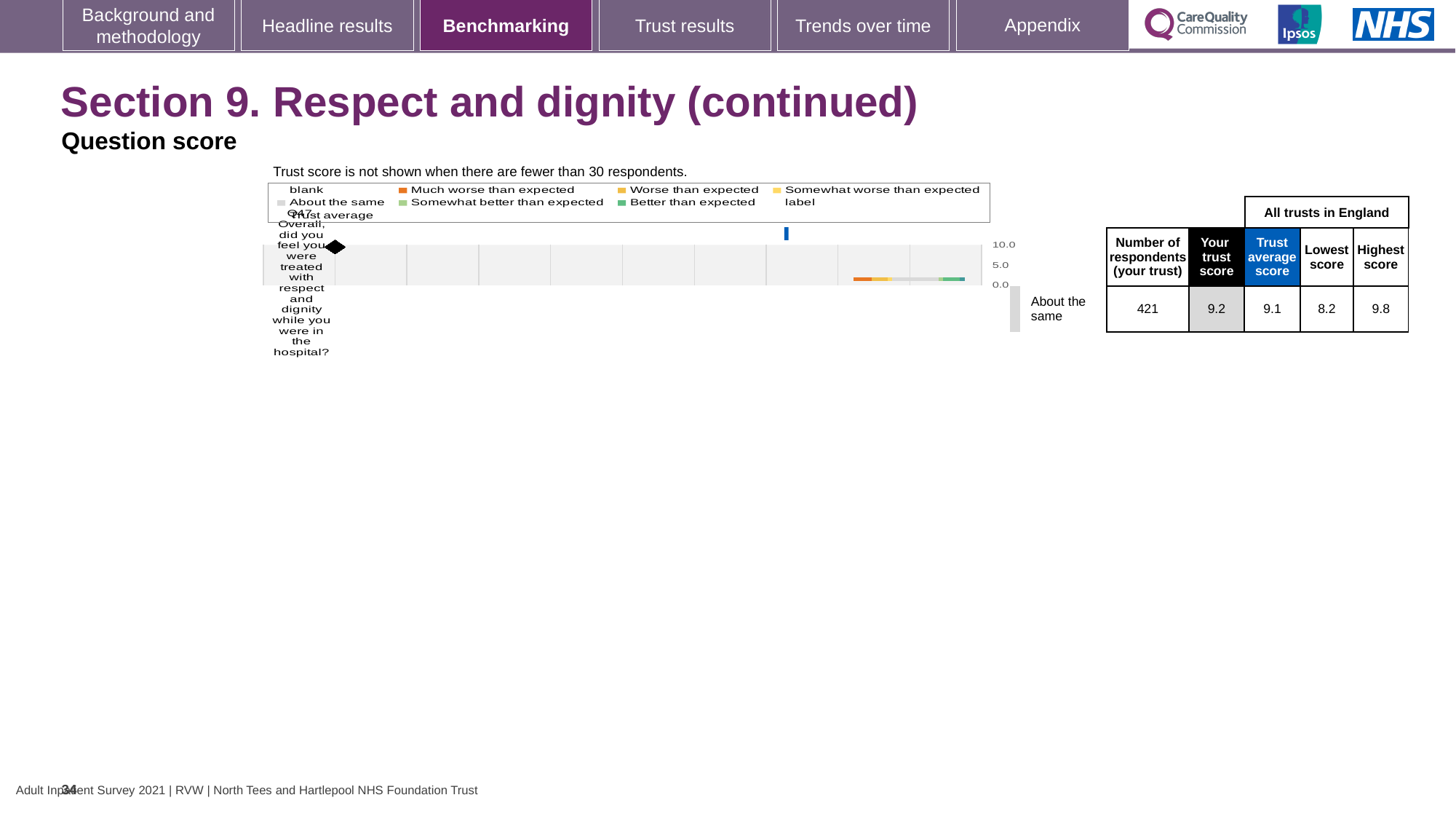
In the table next to the chart, what is the lowest score among all trusts in England? 8.2 In the table next to the chart, what is your trust score for Q47? 9.2 In the table next to the chart, what is the highest score among all trusts in England? 9.8 What kind of chart is shown on the slide? bar chart How many question categories are plotted on the chart? 1 In the table next to the chart, what is the difference between the highest score and the lowest score? 1.6 In the table next to the chart, what is the trust average score? 9.1 How many entries does the chart legend list? 9 Which question is plotted on the chart? Q47 In the table next to the chart, what is the number of respondents for your trust? 421 In the table next to the chart, which is larger: your trust score or the trust average score? Your trust score What is the highest value shown on the chart's axis? 10.0